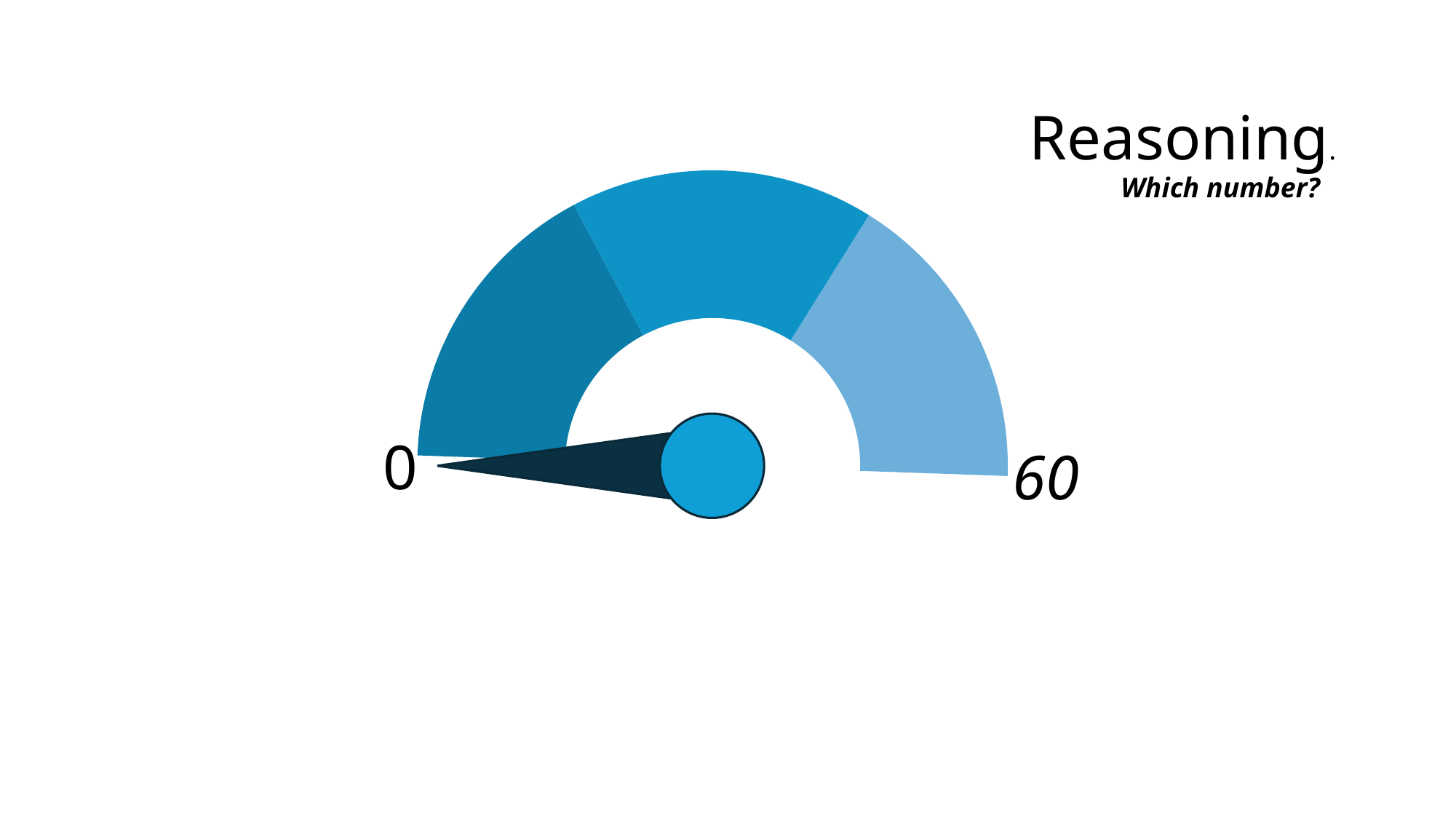
What is the highest value labelled on the gauge scale? 60 What is the difference between the highest and lowest labels on the gauge scale? 60 What subtitle appears below the chart title? Which number? Is the value indicated by the needle greater or less than 60? less Which is larger, the value the needle points to or the maximum label on the gauge? The maximum label (60) What kind of chart is shown on the slide? Gauge chart What is the title of the chart on the slide? Reasoning. What is the lowest value labelled on the gauge scale? 0 What value does the needle of the gauge point to? 0 How many coloured segments make up the gauge arc? 3